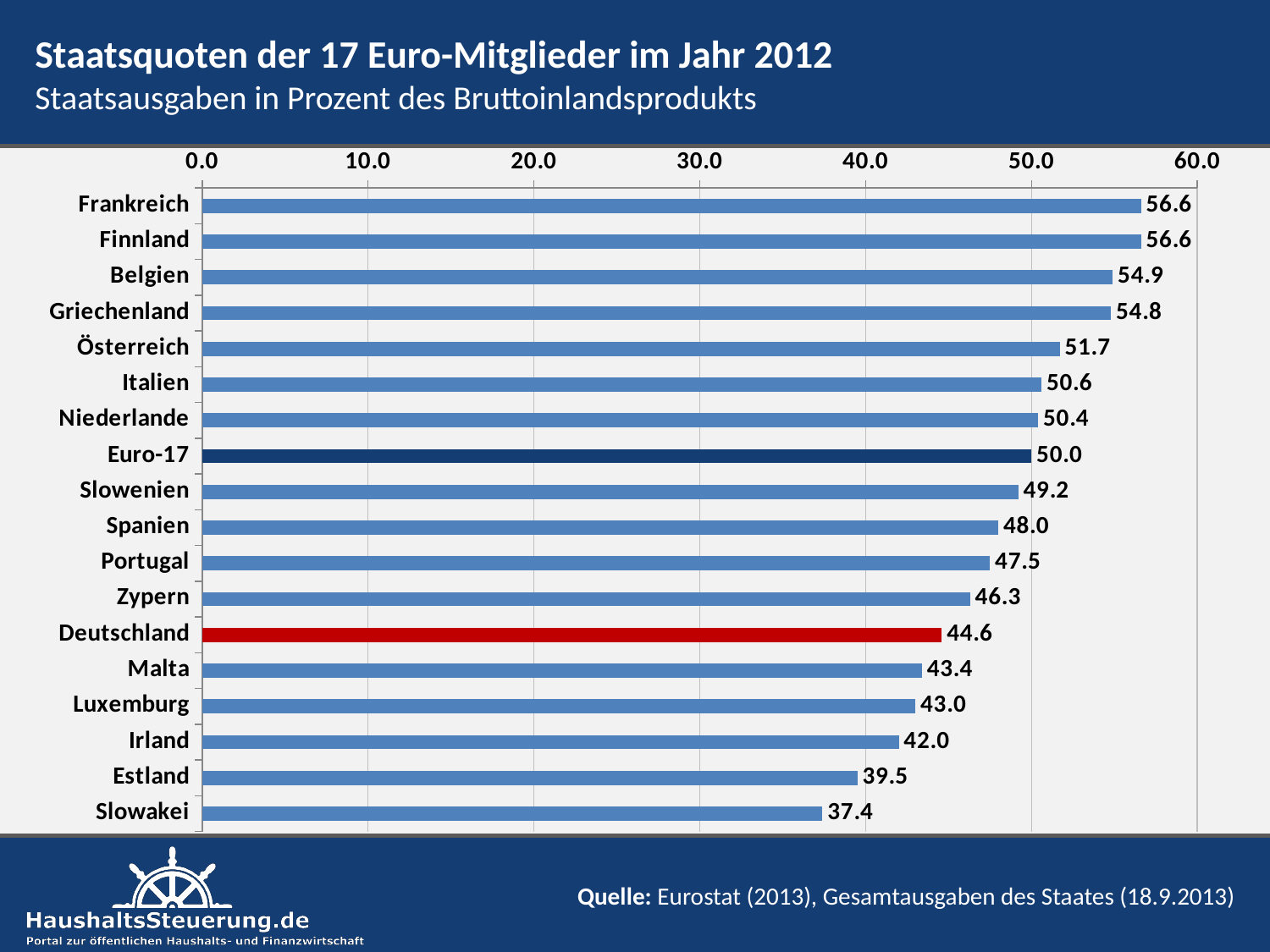
What is the difference between the values for Frankreich and Deutschland? 12.0 What kind of chart is shown on the slide? bar chart Which bar is coloured red? Deutschland How many bars are shown in the chart? 18 What is the value for Deutschland? 44.6 What is the difference between the values for Euro-17 and Slowakei? 12.6 What is the value for Griechenland? 54.8 Is the value for Zypern greater or less than 50.0? less Which has a larger value, Irland or Malta? Malta What is the value for Euro-17? 50.0 Which has a larger value, Spanien or Portugal? Spanien Which category has the lowest value? Slowakei